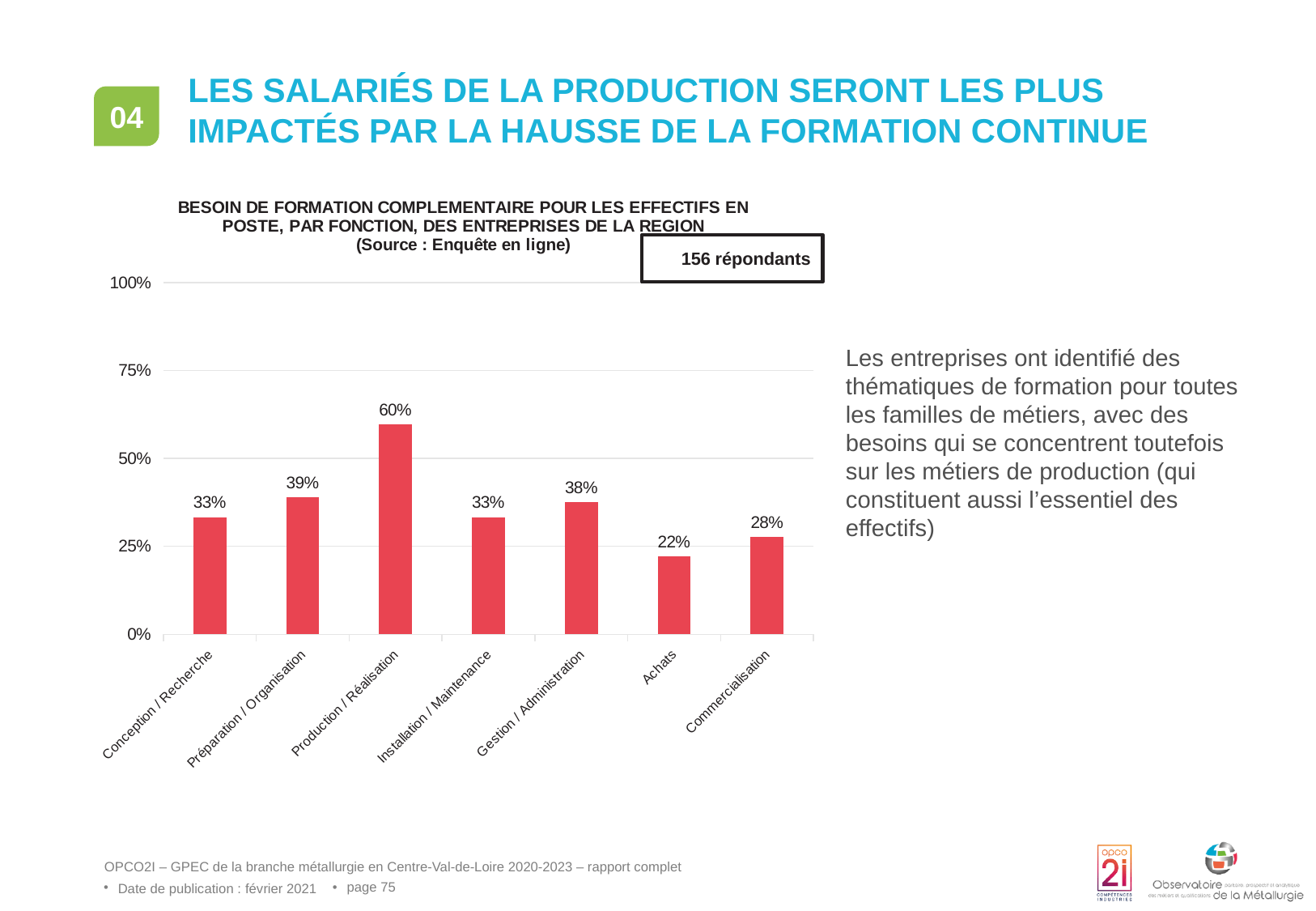
What is the difference between the values for Production / Réalisation and Achats? 38% How many categories are shown on the x axis? 7 What is the value for Gestion / Administration? 38% Which category has the highest value? Production / Réalisation Is the value for Production / Réalisation greater or less than 50%? greater What kind of chart is shown on the slide? bar chart What is the value for Production / Réalisation? 60% What is the value for Commercialisation? 28% What is the value for Achats? 22% Which category has the lowest value? Achats Which is larger, the value for Préparation / Organisation or the value for Commercialisation? Préparation / Organisation How many respondents does the chart indicate? 156 répondants